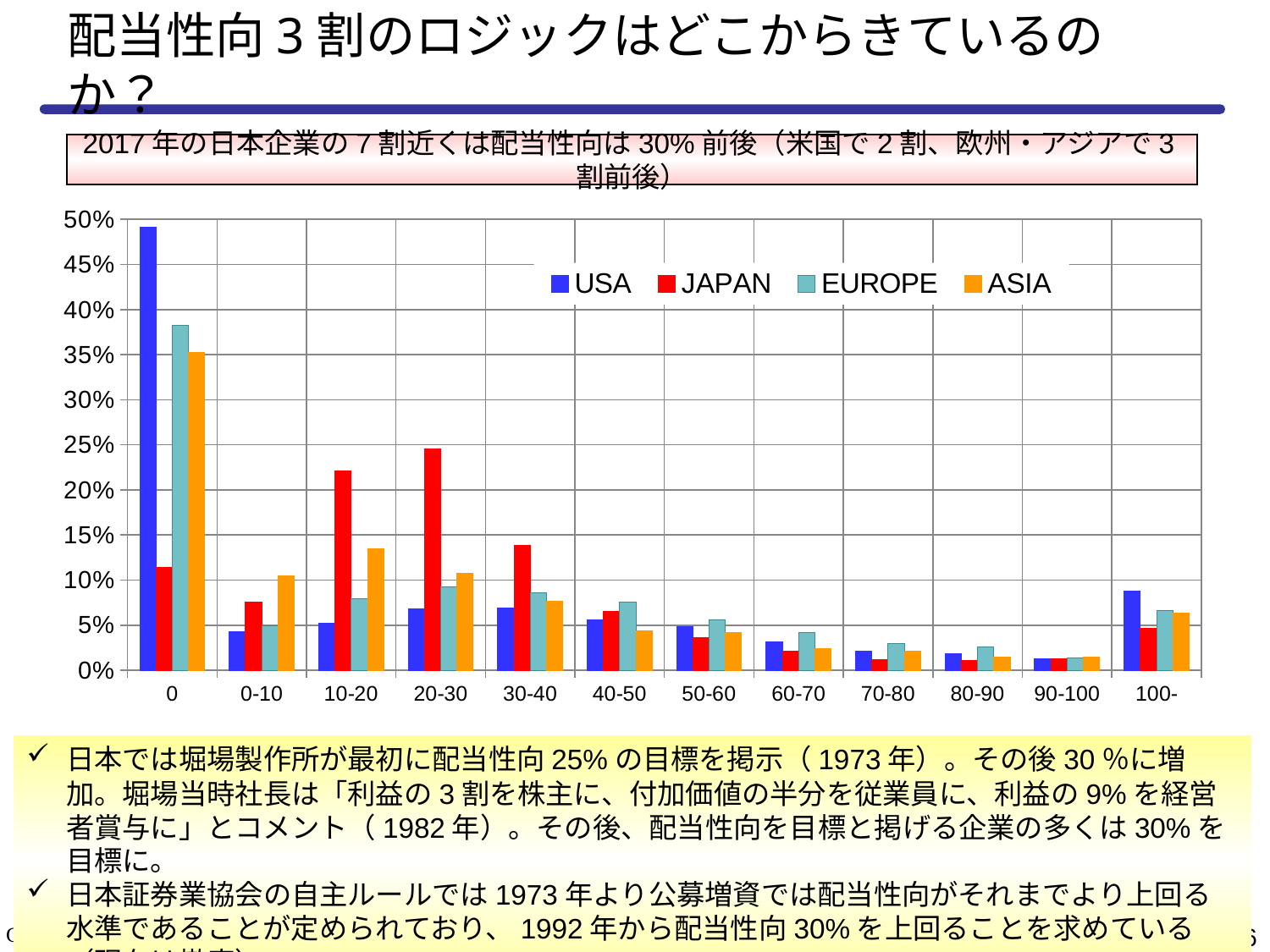
Which series has the highest value in the 20-30 category? JAPAN Which series has the lowest value in the 0 category? JAPAN In which category does the USA series reach its highest value? 0 Which is larger in the 20-30 category, JAPAN or EUROPE? JAPAN Is the value for JAPAN in the 10-20 category greater or less than 20%? greater How many series does the chart legend list? 4 How many categories are shown on the x axis of the chart? 12 Which series has the highest value in the 10-20 category? JAPAN What kind of chart is shown on the slide? bar chart Is the value for JAPAN in the 30-40 category greater or less than 15%? less Is the value for USA in the 0 category greater or less than 45%? greater